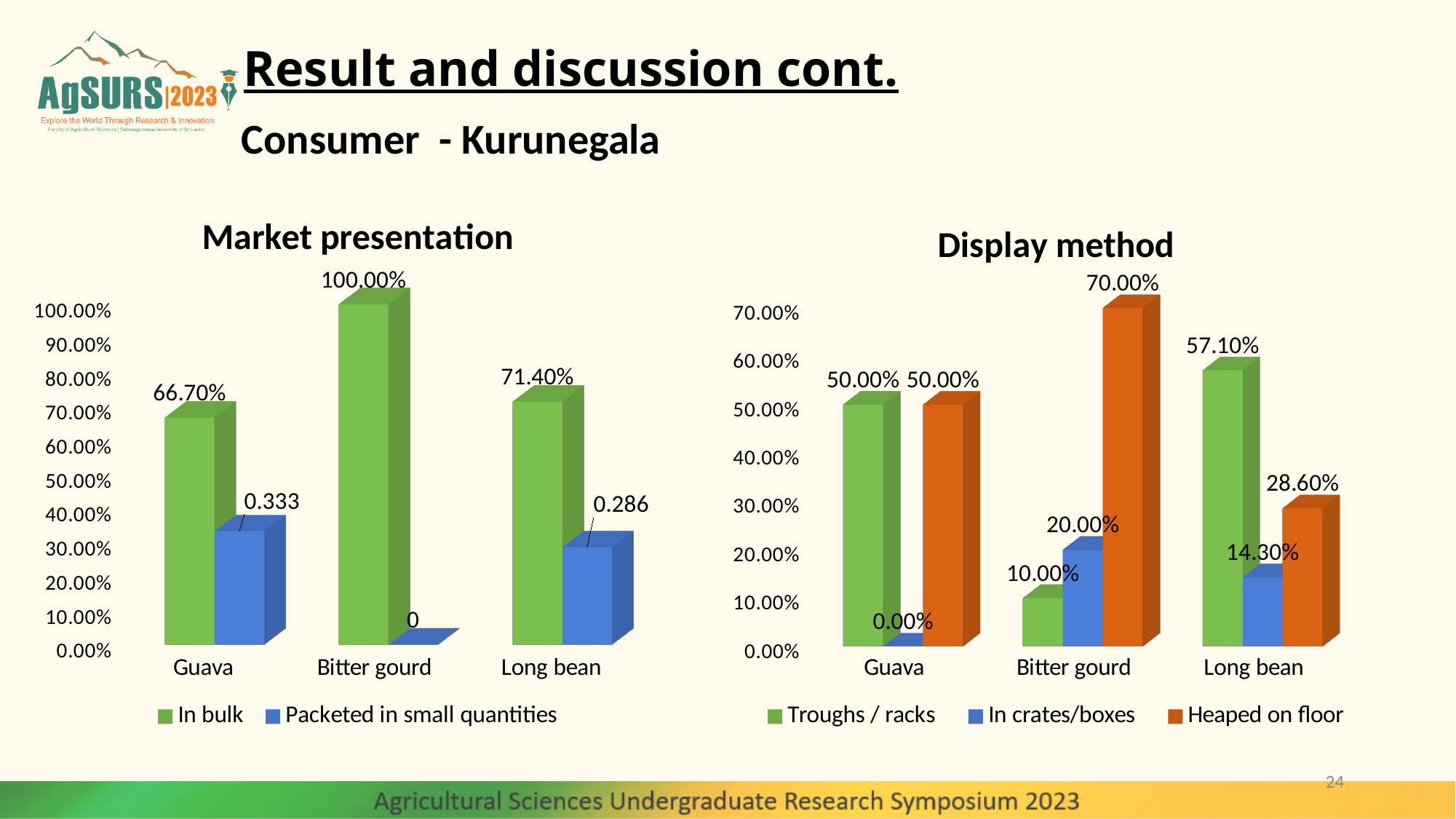
In the Market presentation chart, what is the value for Packeted in small quantities for Guava? 0.333 In the Display method chart, which category has the highest Troughs / racks value? Long bean In the Market presentation chart, how many series does the legend list? 2 In the Display method chart, what is the difference between the Heaped on floor values for Bitter gourd and Long bean? 41.40% In the Display method chart, what is the value for Heaped on floor for Bitter gourd? 70.00% In the Market presentation chart, which category has the lowest In bulk value? Guava In the Market presentation chart, what is the value for In bulk for Bitter gourd? 100.00% In the Display method chart, what is the value for In crates/boxes for Long bean? 14.30% What kind of chart is the Display method chart? Bar chart In the Market presentation chart, what is the difference between the In bulk values for Long bean and Guava? 4.70% In the Display method chart, how many series does the legend list? 3 In the Display method chart, which is larger for Long bean: Troughs / racks or Heaped on floor? Troughs / racks